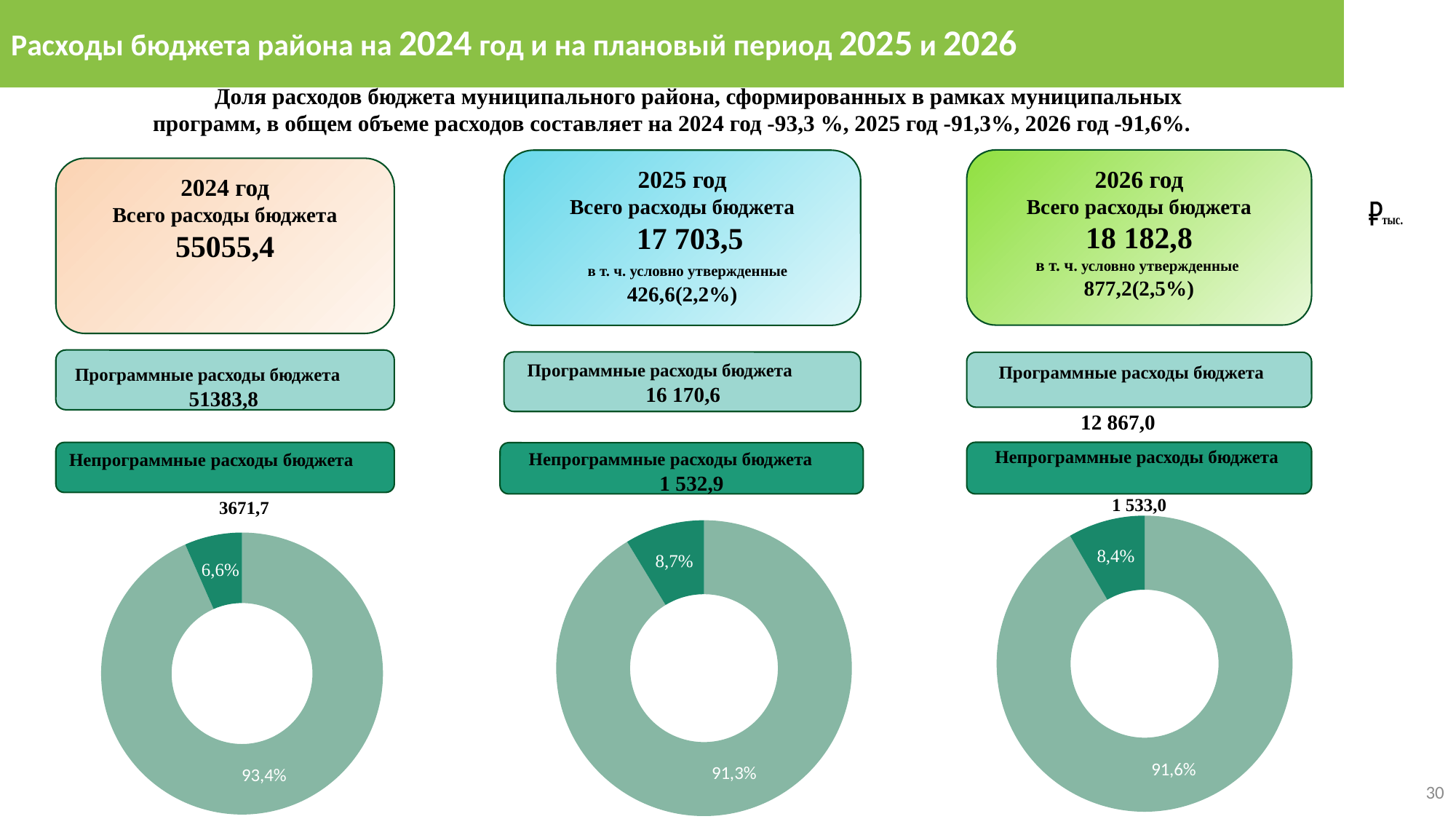
In the left (2024) donut chart, what percentage is shown for the large light-green slice? 93,4% Which donut chart has the smallest dark-green (non-programme) slice: the 2024, 2025 or 2026 chart? 2024 In the right (2026) donut chart, what percentage is shown for the large light-green slice? 91,6% How many donut charts are shown on the slide? 3 How many slices does each donut chart on the slide have? 2 In the left (2024) donut chart, what is the difference in percentage points between the large slice and the small slice? 86,8 In the left (2024) donut chart, what percentage is shown for the small dark-green slice? 6,6% In the middle (2025) donut chart, what percentage is shown for the large light-green slice? 91,3% What kind of chart is shown under the 2024 column at the bottom of the slide? Donut chart In the right (2026) donut chart, what percentage is shown for the small dark-green slice? 8,4% In the middle (2025) donut chart, what percentage is shown for the small dark-green slice? 8,7% Which donut chart has the largest dark-green (non-programme) slice: the 2024, 2025 or 2026 chart? 2025